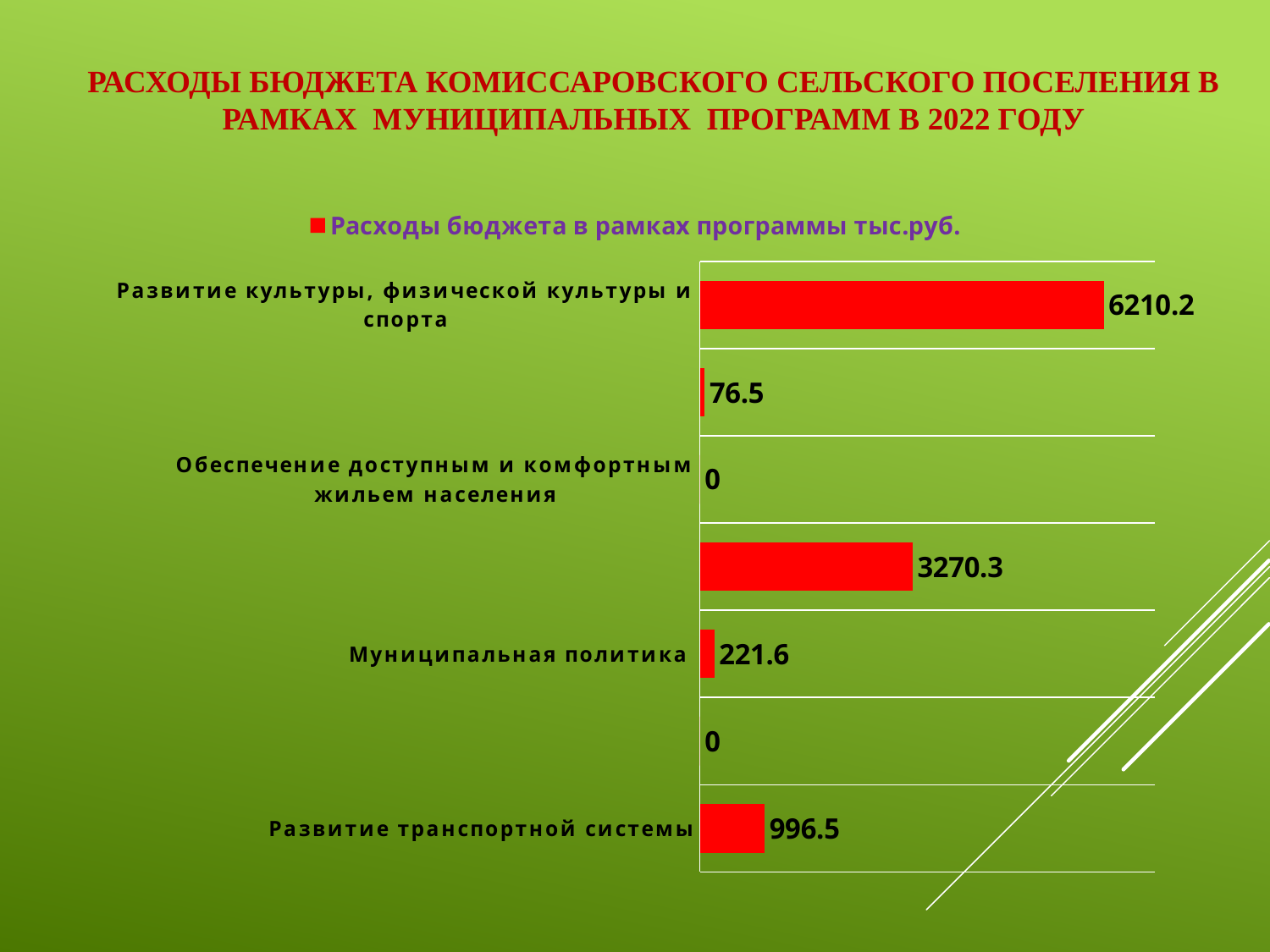
Which is larger, the value for Муниципальная политика or the value for Развитие транспортной системы? Развитие транспортной системы How many bars (data points) are plotted on the chart? 7 What is the value for Развитие транспортной системы? 996.5 What kind of chart is shown on the slide? bar chart What is the value for Обеспечение доступным и комфортным жильем населения? 0 What is the difference between the values for Развитие культуры, физической культуры и спорта and Развитие транспортной системы? 5213.7 What is the largest value shown on the chart? 6210.2 Which category has the highest value? Развитие культуры, физической культуры и спорта What is the value for Муниципальная политика? 221.6 What is the value for Развитие культуры, физической культуры и спорта? 6210.2 What is the difference between the values for Развитие транспортной системы and Муниципальная политика? 774.9 How many series does the legend list? 1